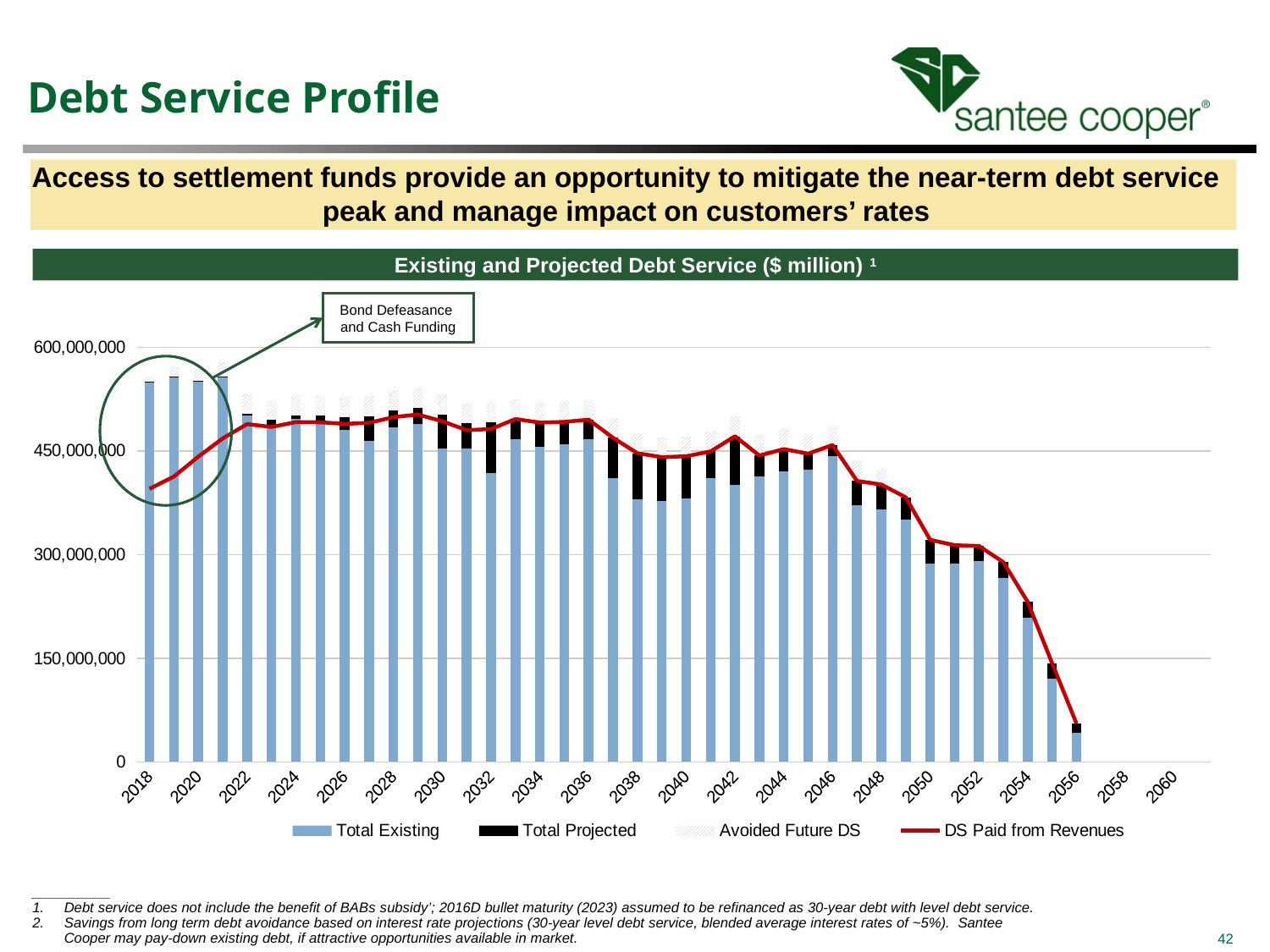
How many series does the chart legend list? 4 Is the Total Existing value for 2018 greater or less than 450,000,000? greater Which year has a larger Total Existing value, 2030 or 2040? 2030 Overall, do the bar values rise or fall from 2018 to 2056? fall Among the years with bars, which year has the lowest total debt service? 2056 What kind of chart is shown on the slide? Bar chart with a line overlay What is the title of the chart? Existing and Projected Debt Service ($ million) Is the Total Existing value for 2056 greater or less than 150,000,000? less Which year has a larger Total Existing value, 2018 or 2056? 2018 Is the Total Existing value for 2054 greater or less than 300,000,000? less Which legend entry is drawn as a red line? DS Paid from Revenues